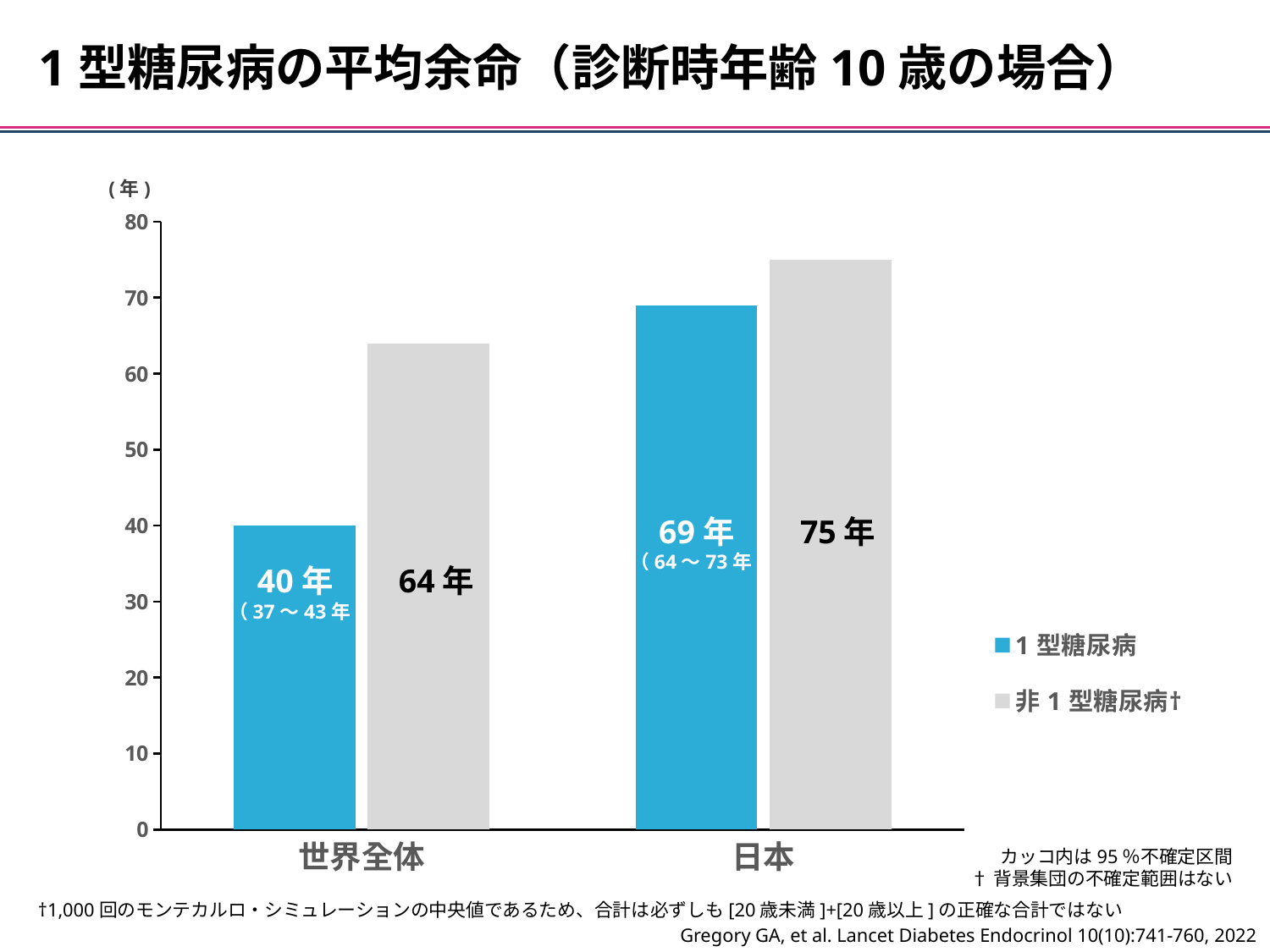
What kind of chart is shown on the slide? Bar chart Which is larger: 1型糖尿病 in 日本 or 非1型糖尿病 in 世界全体? 1型糖尿病 in 日本 What is the value for 非1型糖尿病 in 世界全体? 64 年 Which bar has the lowest value on the chart? 1型糖尿病 in 世界全体 What is the value for 1型糖尿病 in 日本? 69 年 Which bar has the highest value on the chart? 非1型糖尿病 in 日本 How many series does the legend list? 2 What is the average remaining life expectancy for 非1型糖尿病 in 日本? 75 年 What is the 95% uncertainty interval shown for 1型糖尿病 in 世界全体? 37～43 年 What is the difference between 非1型糖尿病 and 1型糖尿病 in 日本? 6 年 What is the difference between 非1型糖尿病 and 1型糖尿病 in 世界全体? 24 年 What is the average remaining life expectancy for 1型糖尿病 in 世界全体? 40 年